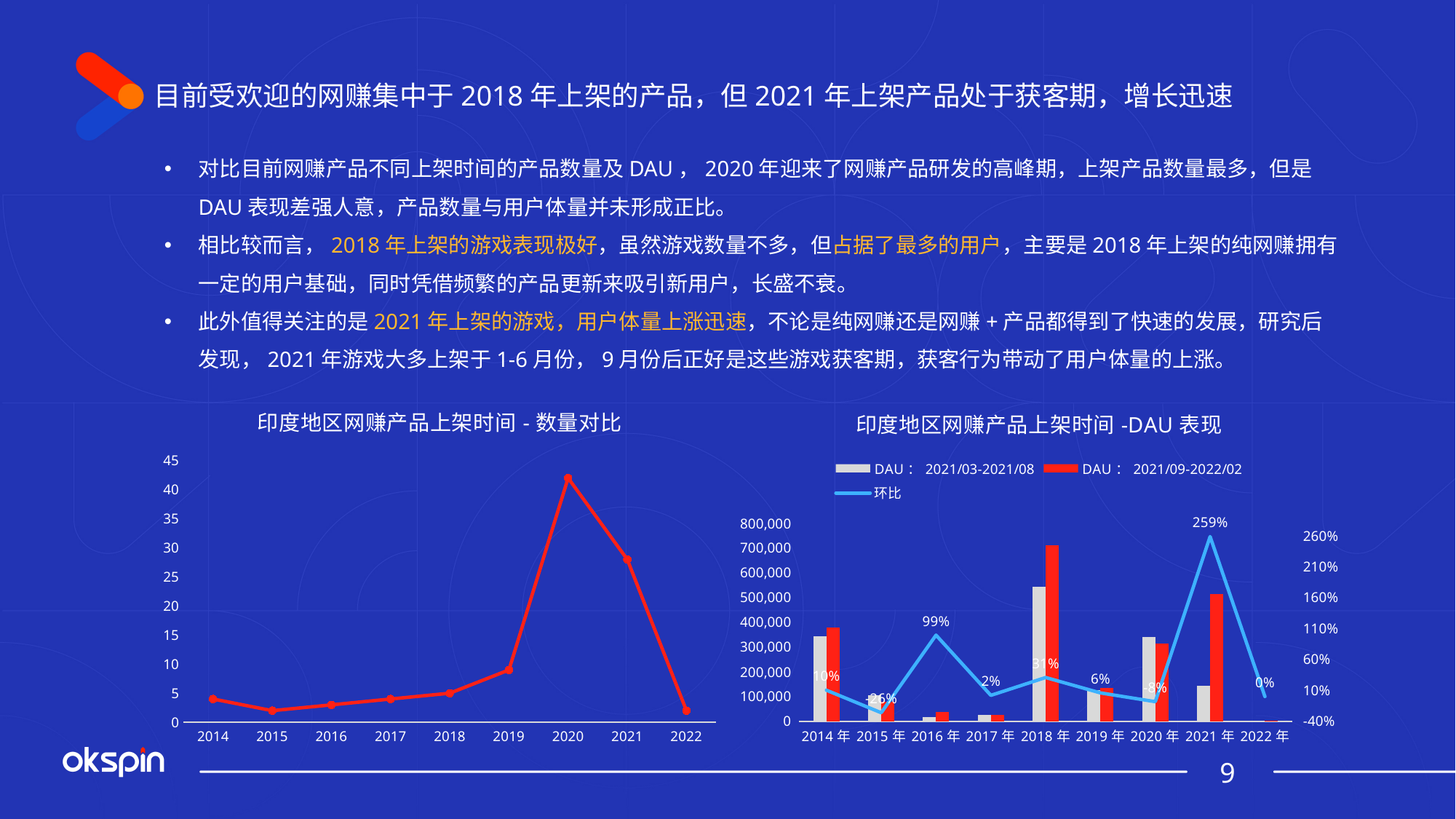
How many series does the legend of the right chart (印度地区网赚产品上架时间 -DAU 表现) list? 3 In the left chart (印度地区网赚产品上架时间 - 数量对比), is the value for 2020 greater or less than 40? greater In the right chart (印度地区网赚产品上架时间 -DAU 表现), which year has the tallest red bar (DAU: 2021/09-2022/02)? 2018 年 In the right chart (印度地区网赚产品上架时间 -DAU 表现), what is the 环比 value for 2021 年? 259% How many years are plotted on the x axis of the left chart (印度地区网赚产品上架时间 - 数量对比)? 9 In the left chart (印度地区网赚产品上架时间 - 数量对比), which year has the highest value? 2020 In the right chart (印度地区网赚产品上架时间 -DAU 表现), what is the 环比 value for 2015 年? -26% In the right chart (印度地区网赚产品上架时间 -DAU 表现), which year has the highest 环比 value? 2021 年 In the left chart (印度地区网赚产品上架时间 - 数量对比), is the value for 2018 greater or less than 10? less In the left chart (印度地区网赚产品上架时间 - 数量对比), do the values rise or fall from 2020 to 2022? fall What kind of chart is the left chart titled 印度地区网赚产品上架时间 - 数量对比? line chart In the right chart (印度地区网赚产品上架时间 -DAU 表现), what is the 环比 value for 2016 年? 99%